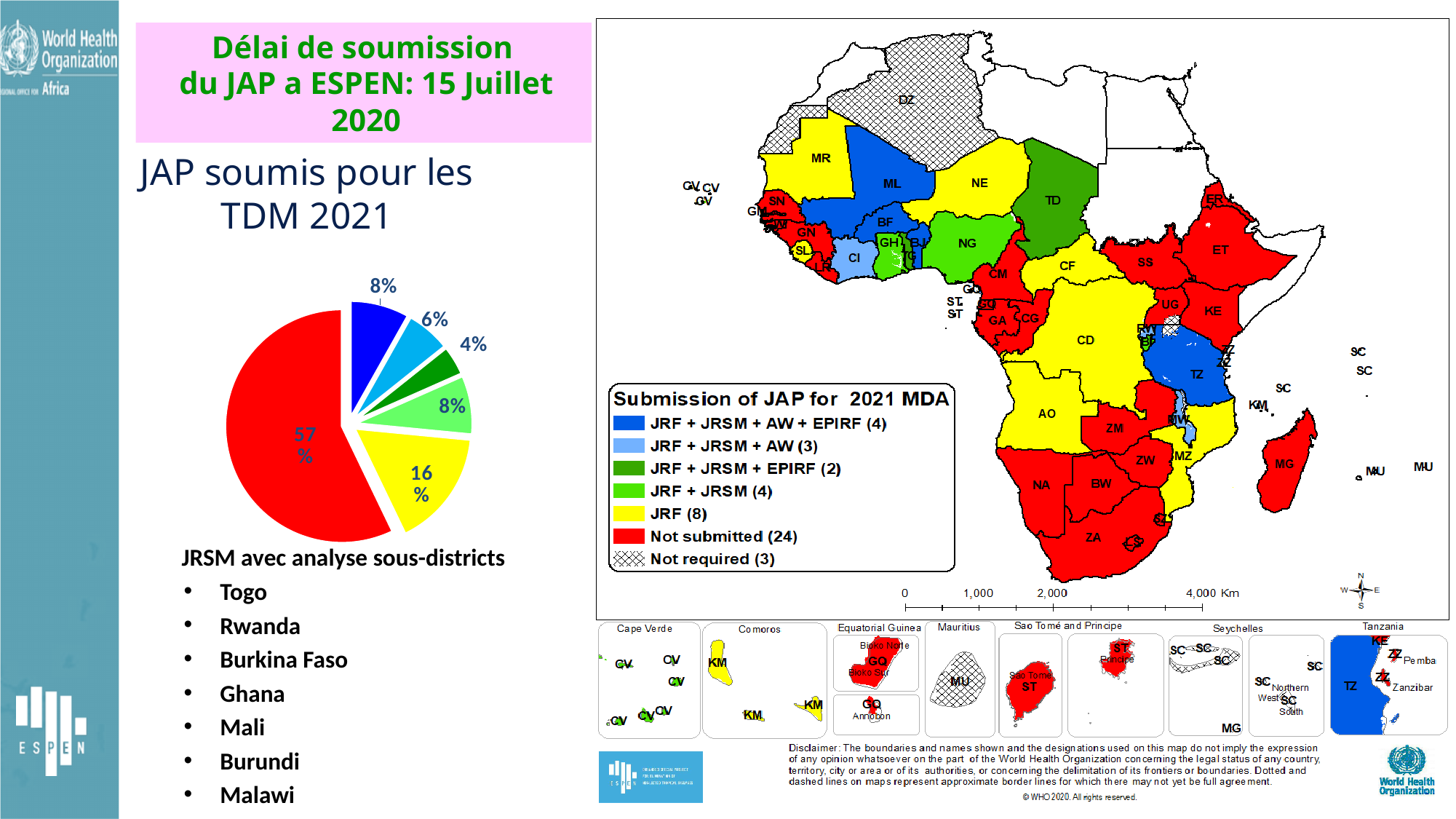
How many slices does the pie chart have? 6 What percentage is shown for the dark green slice of the pie chart? 4% What is the title written above the pie chart? JAP soumis pour les TDM 2021 What kind of chart is shown on the left of the slide under 'JAP soumis pour les TDM 2021'? pie chart What percentage is shown for the light blue slice of the pie chart? 6% What is the combined share of the dark blue slice and the light green slice of the pie chart? 16% What percentage is shown for the yellow slice of the pie chart? 16% Which slice of the pie chart is the smallest? the dark green slice (4%) Which slice of the pie chart is the largest? the red slice (57%) Which is larger in the pie chart, the yellow slice or the light blue slice? the yellow slice What percentage is shown for the red slice of the pie chart? 57% What is the difference in percentage points between the red slice and the yellow slice of the pie chart? 41